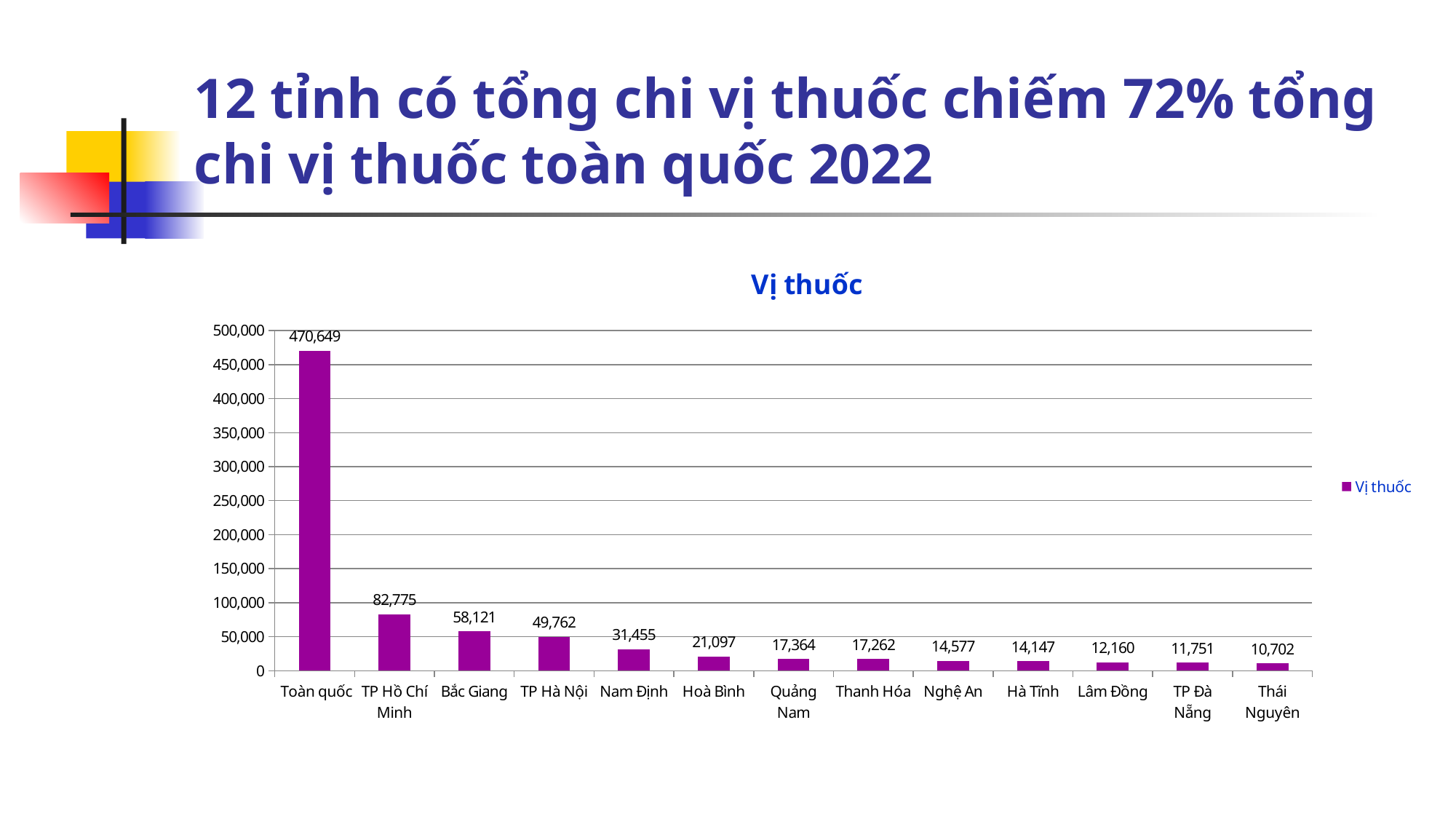
How many series does the legend list? 1 What is the value for Toàn quốc? 470,649 How many categories are shown on the x axis of the chart? 13 What type of chart is shown on the slide? bar chart What is the difference between the values for TP Hồ Chí Minh and Bắc Giang? 24,654 Which category has the lowest value? Thái Nguyên Which category has the highest value? Toàn quốc What is the value for Nghệ An? 14,577 Which is larger, the value for Bắc Giang or the value for TP Hà Nội? Bắc Giang What is the title of the chart? Vị thuốc What is the value for TP Hồ Chí Minh? 82,775 Is the value for TP Hồ Chí Minh greater or less than 50,000? greater